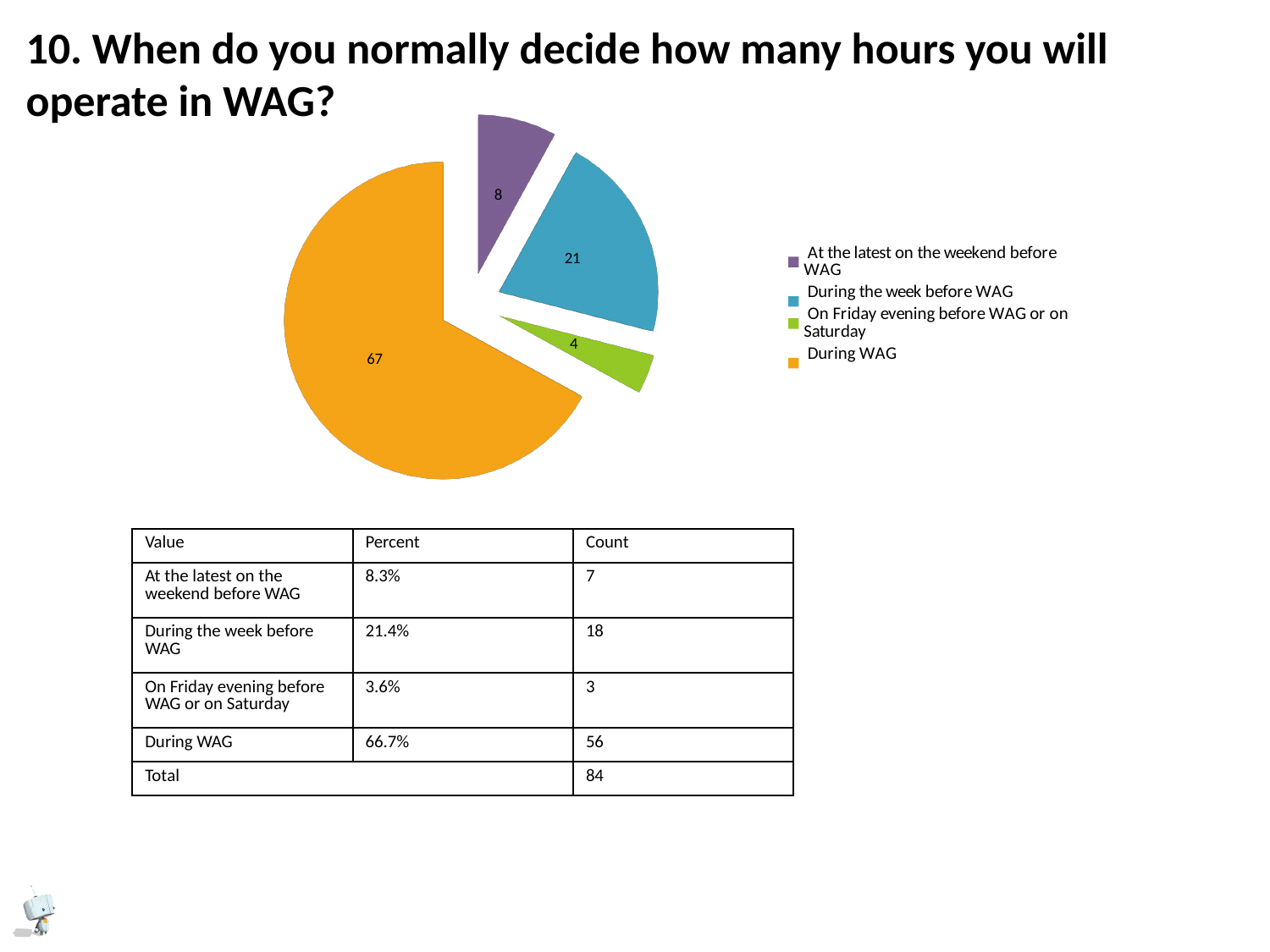
What is the data label on the pie slice for 'During WAG'? 67 Which category has the smallest slice in the pie chart? On Friday evening before WAG or on Saturday Which category has the largest slice in the pie chart? During WAG How many entries does the legend of the pie chart list? 4 Which slice is larger in the pie chart: 'At the latest on the weekend before WAG' or 'During the week before WAG'? During the week before WAG What is the data label on the pie slice for 'On Friday evening before WAG or on Saturday'? 4 How many slices does the pie chart have? 4 What is the data label on the pie slice for 'At the latest on the weekend before WAG'? 8 What type of chart is shown on the slide? pie chart What colour is the 'During WAG' slice in the pie chart? orange What is the data label on the pie slice for 'During the week before WAG'? 21 What is the difference between the data labels for 'During WAG' and 'During the week before WAG' in the pie chart? 46